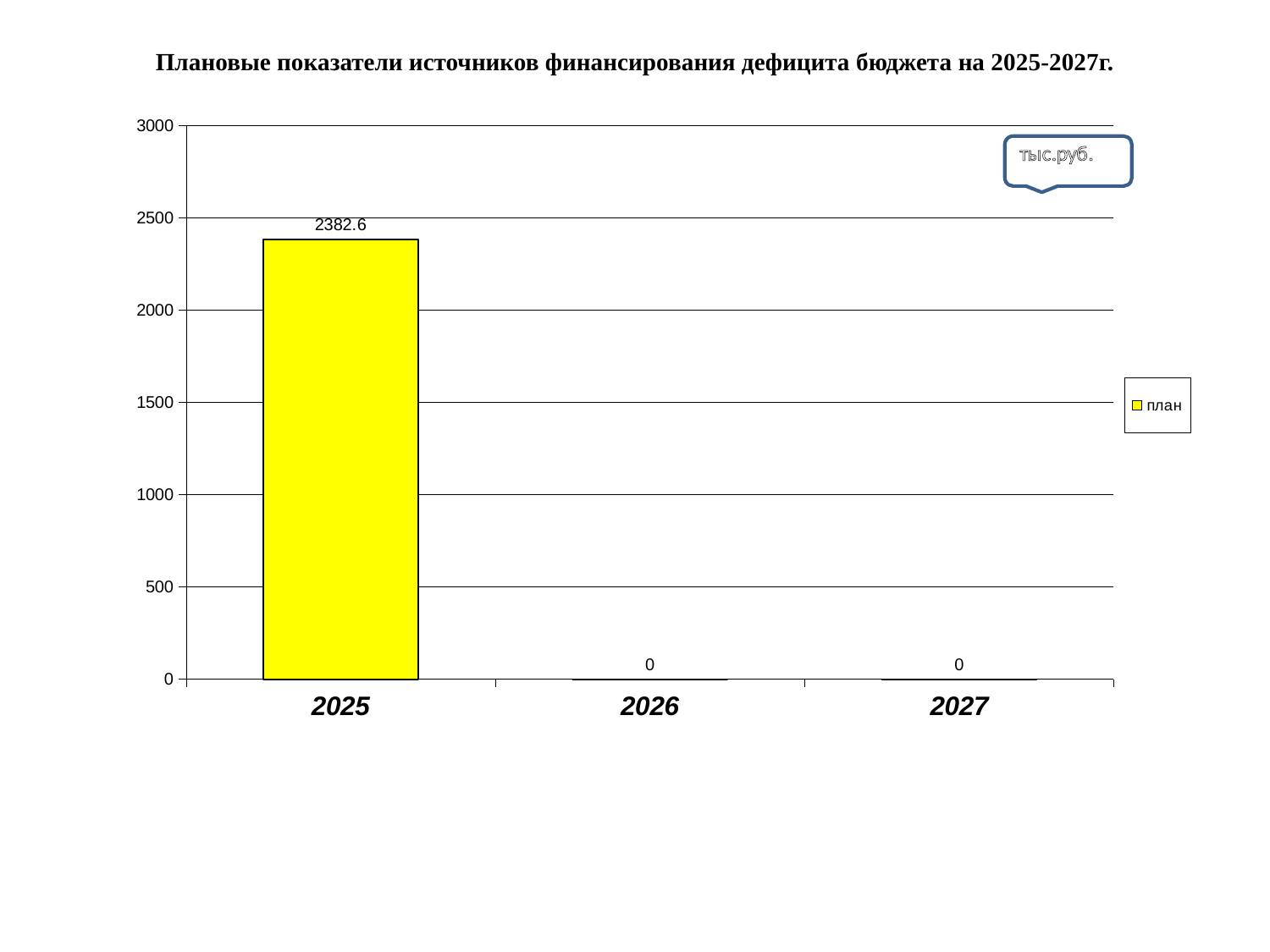
Which is larger, the value for 2025 or the value for 2027? 2025 What is the difference between the values for 2025 and 2026? 2382.6 What kind of chart is shown? bar chart What is the name of the series in the legend? план How many years are shown on the x axis? 3 Is the value for 2025 greater or less than 2000? greater How many series does the legend list? 1 What is the value for 2025? 2382.6 Which year has the highest value? 2025 What is the value for 2026? 0 What is the value for 2027? 0 Is the value for 2025 greater or less than 2500? less